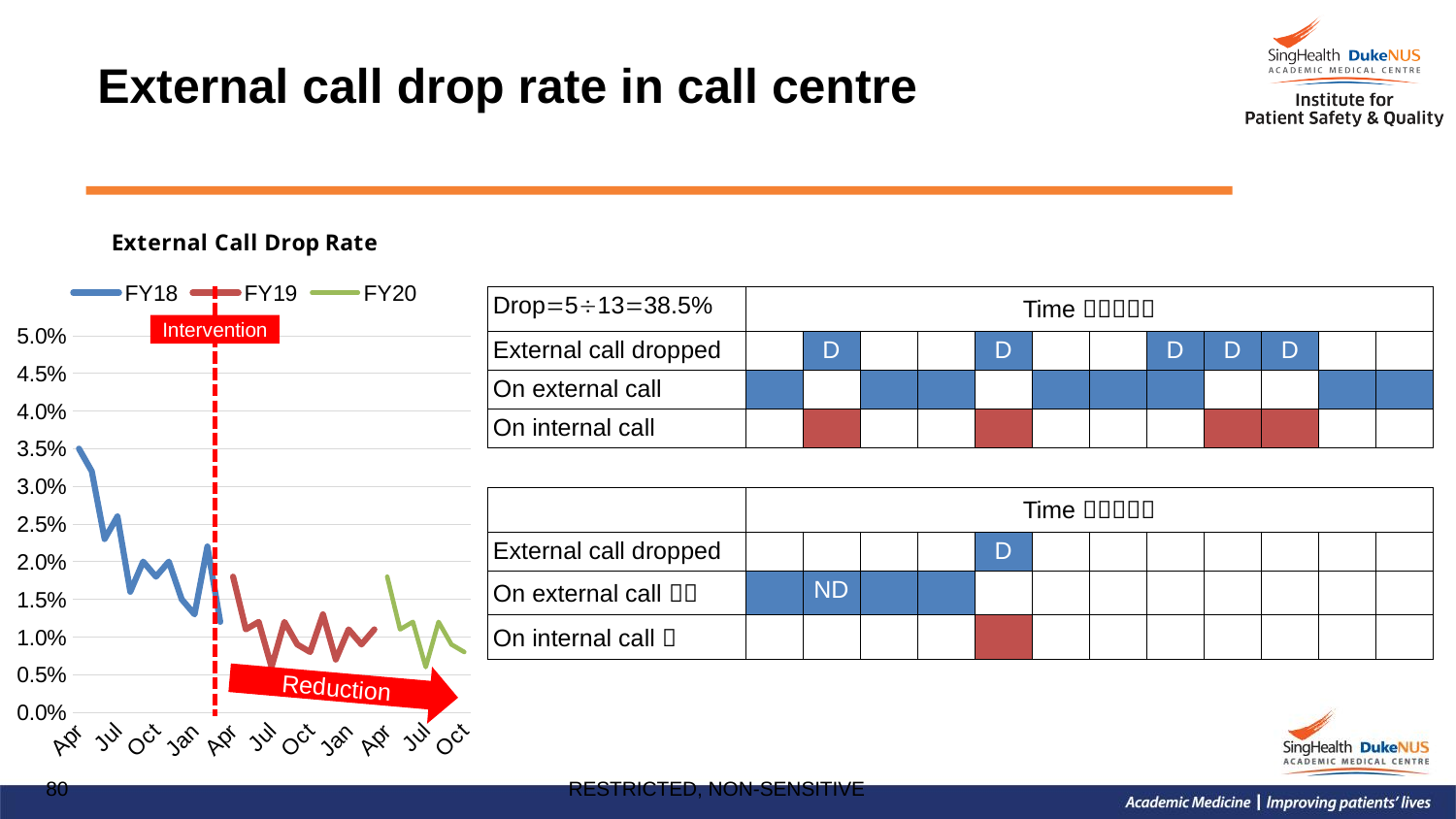
What kind of chart is shown on the slide? line chart Which is larger: the first FY18 value or the first FY20 value? FY18 Is the highest FY20 value greater or less than 2.0%? less What is the title of the chart on the slide? External Call Drop Rate What is the maximum value shown on the y axis of the chart? 5.0% What are the series names in the legend of the External Call Drop Rate chart? FY18, FY19, FY20 Which series reaches the highest drop rate on the chart? FY18 How many series does the legend of the External Call Drop Rate chart list? 3 Is the first FY18 value (Apr) greater or less than 3.0%? greater Does the FY18 series rise or fall over time along the x axis? fall Is the lowest FY20 value greater or less than 1.0%? less